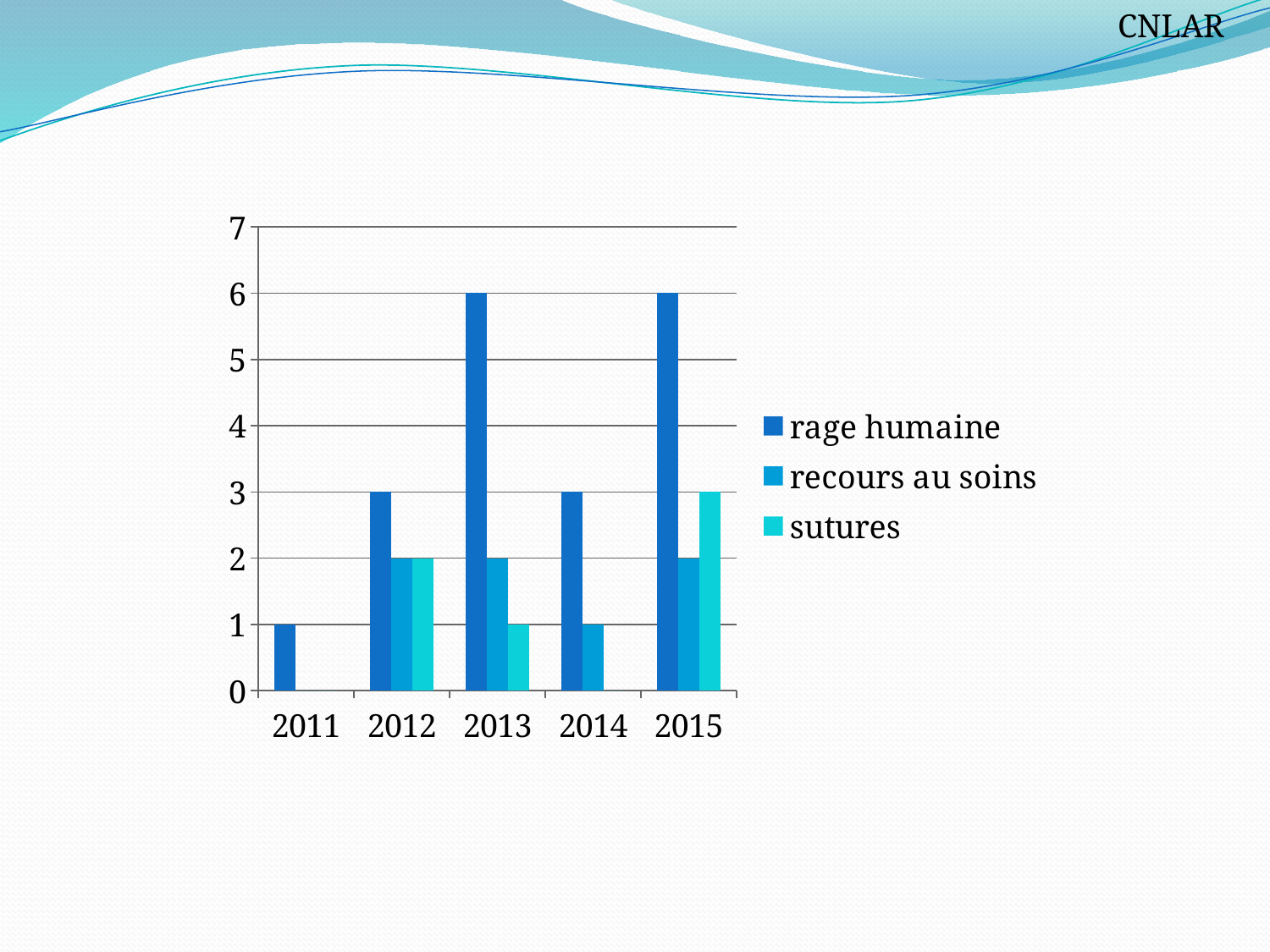
How many years are shown on the x axis? 5 What is the difference between rage humaine in 2013 and rage humaine in 2014? 3 Which series is shown in the darkest blue colour? rage humaine What is the value for sutures in 2015? 3 What is the value for rage humaine in 2011? 1 How many series does the legend list? 3 In which year is the value for rage humaine lowest? 2011 Which is larger, rage humaine in 2012 or recours au soins in 2012? rage humaine in 2012 What kind of chart is shown on the slide? bar chart What is the value for rage humaine in 2013? 6 In which year is the value for sutures highest? 2015 What is the value for recours au soins in 2014? 1